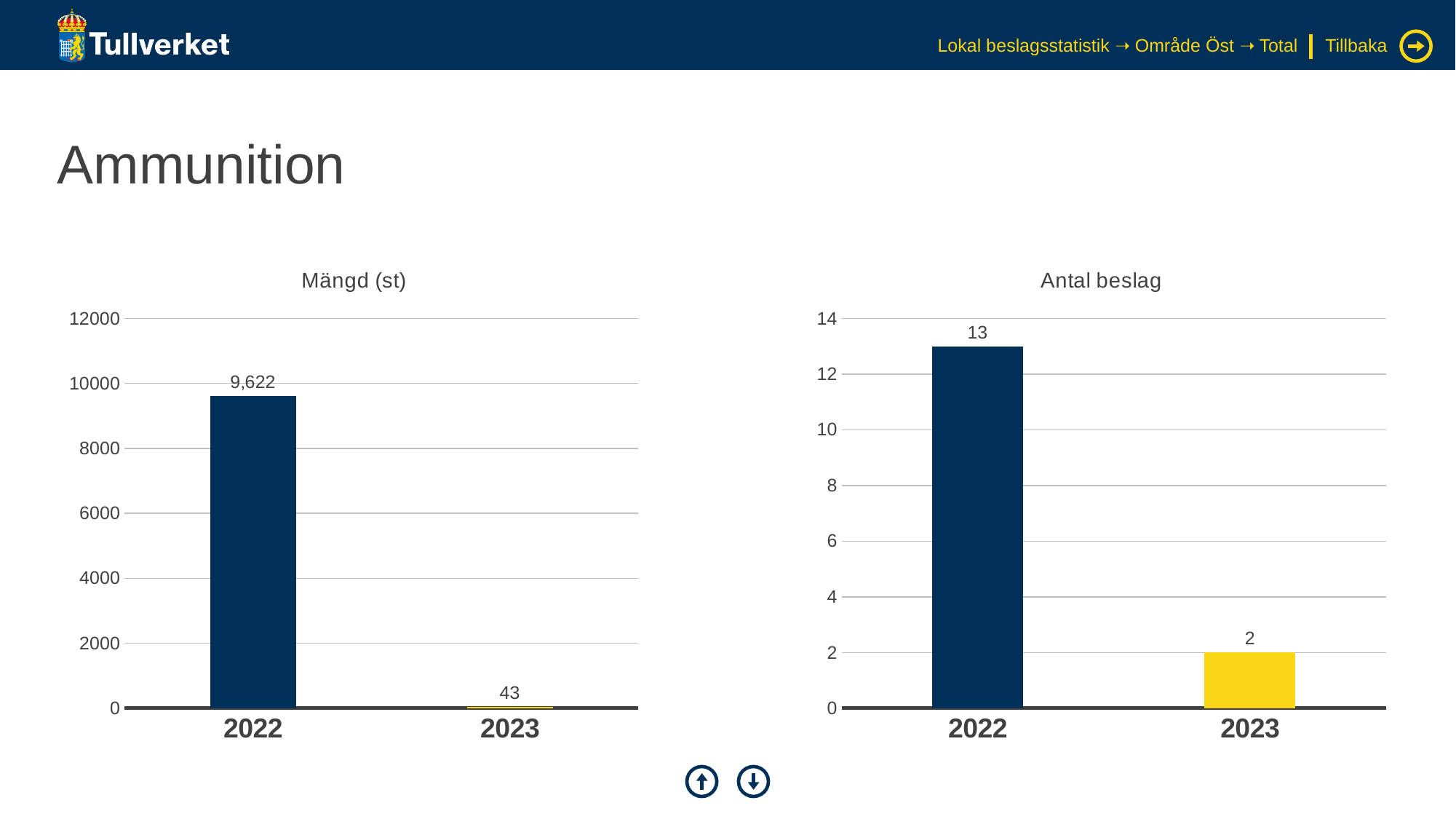
In the 'Antal beslag' chart, which year has the lowest value? 2023 In the 'Mängd (st)' chart, what is the value for 2022? 9,622 In the 'Mängd (st)' chart, what is the difference between the 2022 and 2023 values? 9,579 In the 'Antal beslag' chart, what is the difference between the 2022 and 2023 values? 11 In the 'Antal beslag' chart, what is the value for 2022? 13 In the 'Mängd (st)' chart, what is the value for 2023? 43 In the 'Antal beslag' chart, what is the value for 2023? 2 In the 'Mängd (st)' chart, which year has the highest value? 2022 What kind of chart is the 'Mängd (st)' chart? bar chart In the 'Mängd (st)' chart, is the value for 2022 greater or less than 8000? greater In the 'Antal beslag' chart, do the values rise or fall from 2022 to 2023? fall How many categories are shown on the x axis of the 'Antal beslag' chart? 2